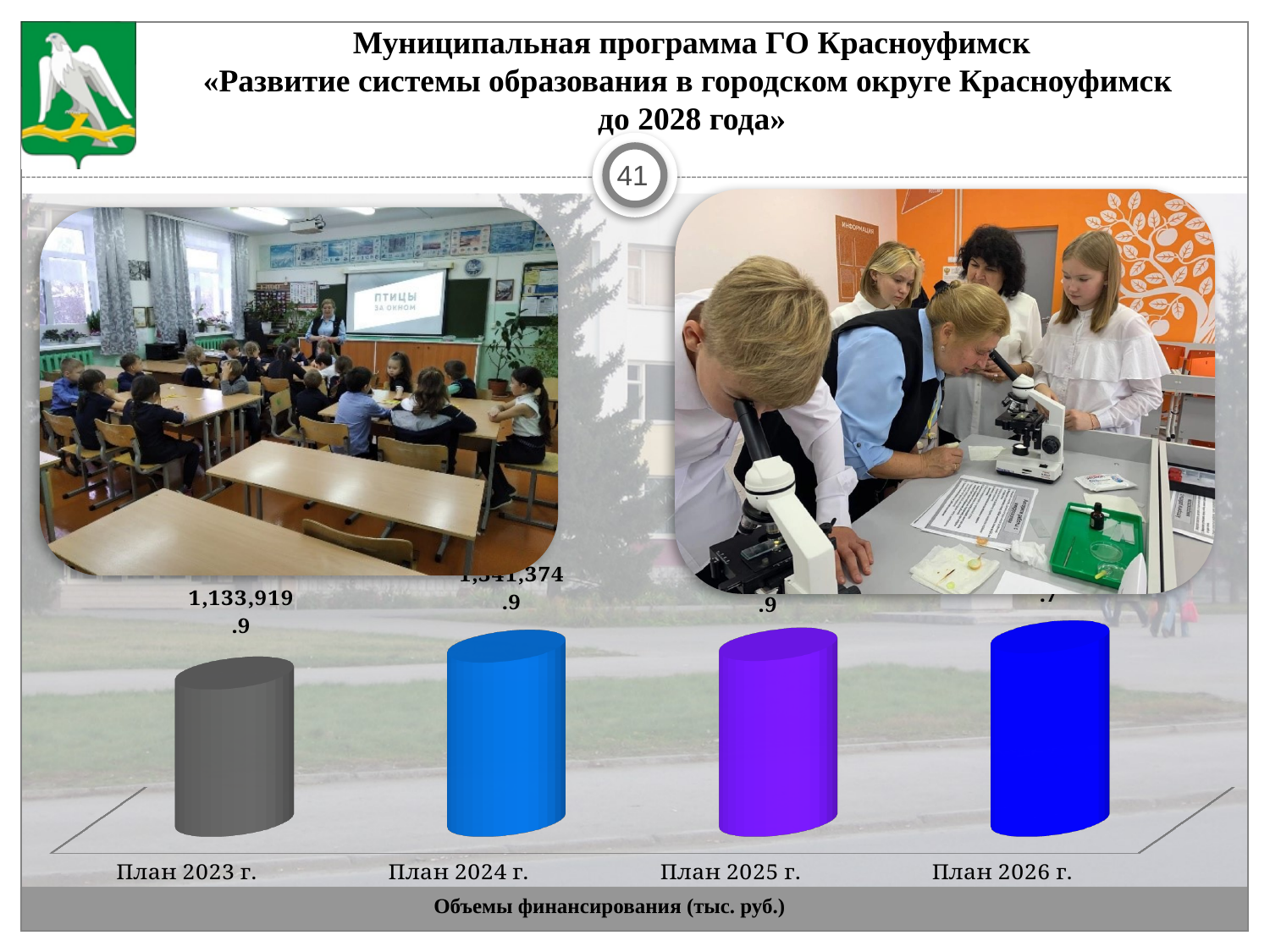
Which category has the lowest value? План 2023 г. What colour is the bar for План 2023 г.? grey What kind of chart is shown on the slide? bar chart What is the value for План 2023 г.? 1,133,919.9 What is the value for План 2024 г.? 1,341,374.9 What is the difference between the values for План 2024 г. and План 2023 г.? 207,455.0 How many categories are shown on the chart? 4 Which is larger, the value for План 2023 г. or План 2024 г.? План 2024 г. What is the caption below the chart? Объемы финансирования (тыс. руб.)